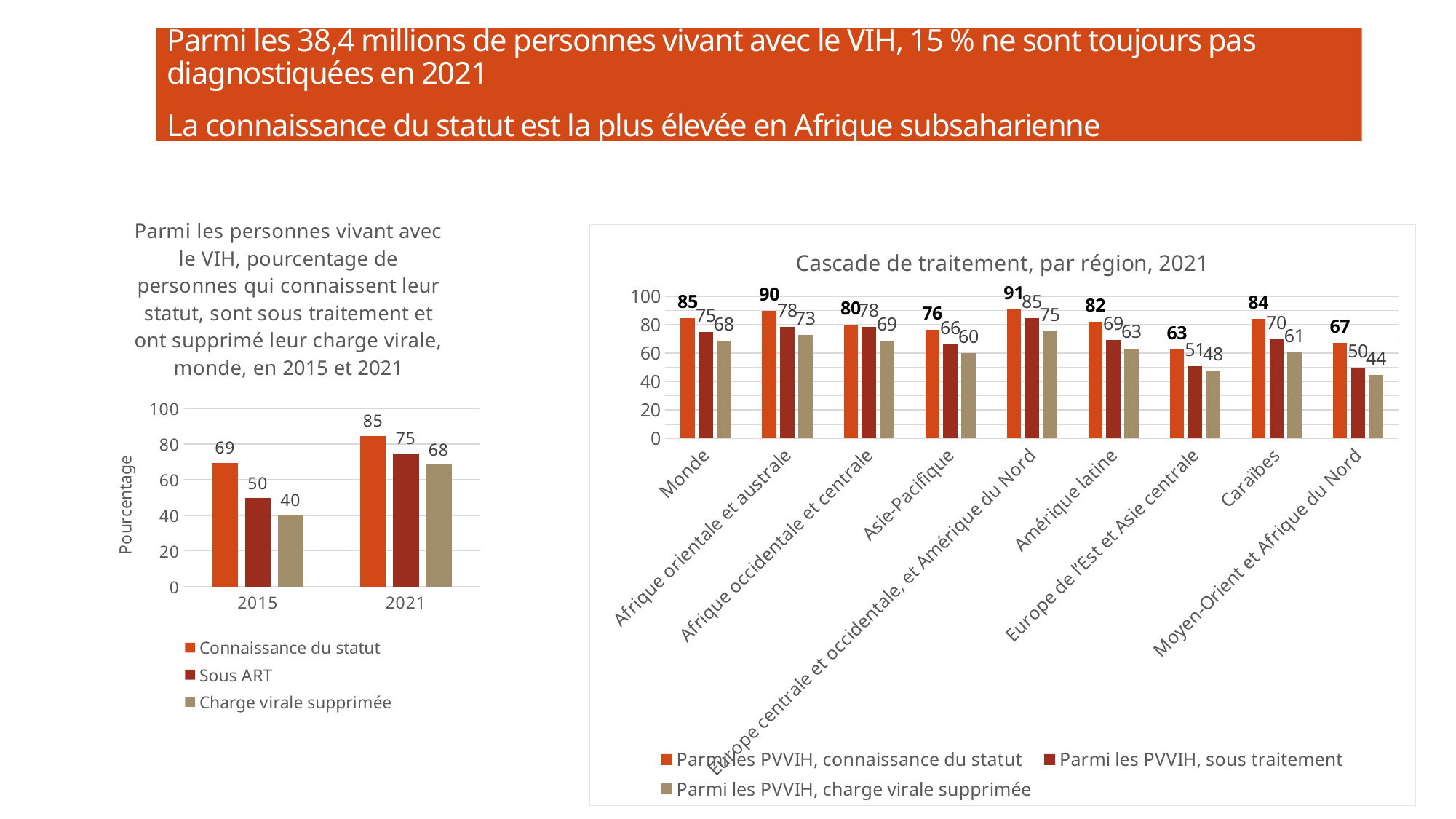
In the chart 'Cascade de traitement, par région, 2021', which region has the highest value for 'Parmi les PVVIH, connaissance du statut'? Europe centrale et occidentale, et Amérique du Nord In the chart 'Cascade de traitement, par région, 2021', which is larger: 'Parmi les PVVIH, sous traitement' for Caraïbes or for Amérique latine? Caraïbes In the left chart (monde, 2015 et 2021), how many series does the legend list? 3 In the chart 'Cascade de traitement, par région, 2021', how many regions are shown on the x axis? 9 What kind of chart is 'Cascade de traitement, par région, 2021'? bar chart In the chart 'Cascade de traitement, par région, 2021', which region has the lowest value for 'Parmi les PVVIH, charge virale supprimée'? Moyen-Orient et Afrique du Nord In the left chart (monde, 2015 et 2021), by how much did Sous ART increase from 2015 to 2021? 25 In the left chart (monde, 2015 et 2021), what is the value for Charge virale supprimée in 2015? 40 In the chart 'Cascade de traitement, par région, 2021', what is the value for 'Parmi les PVVIH, connaissance du statut' in Afrique orientale et australe? 90 In the left chart (monde, 2015 et 2021), does Charge virale supprimée rise or fall from 2015 to 2021? rise In the left chart (monde, 2015 et 2021), what is the value for Connaissance du statut in 2021? 85 In the chart 'Cascade de traitement, par région, 2021', what is the difference between 'connaissance du statut' and 'charge virale supprimée' for Asie-Pacifique? 16